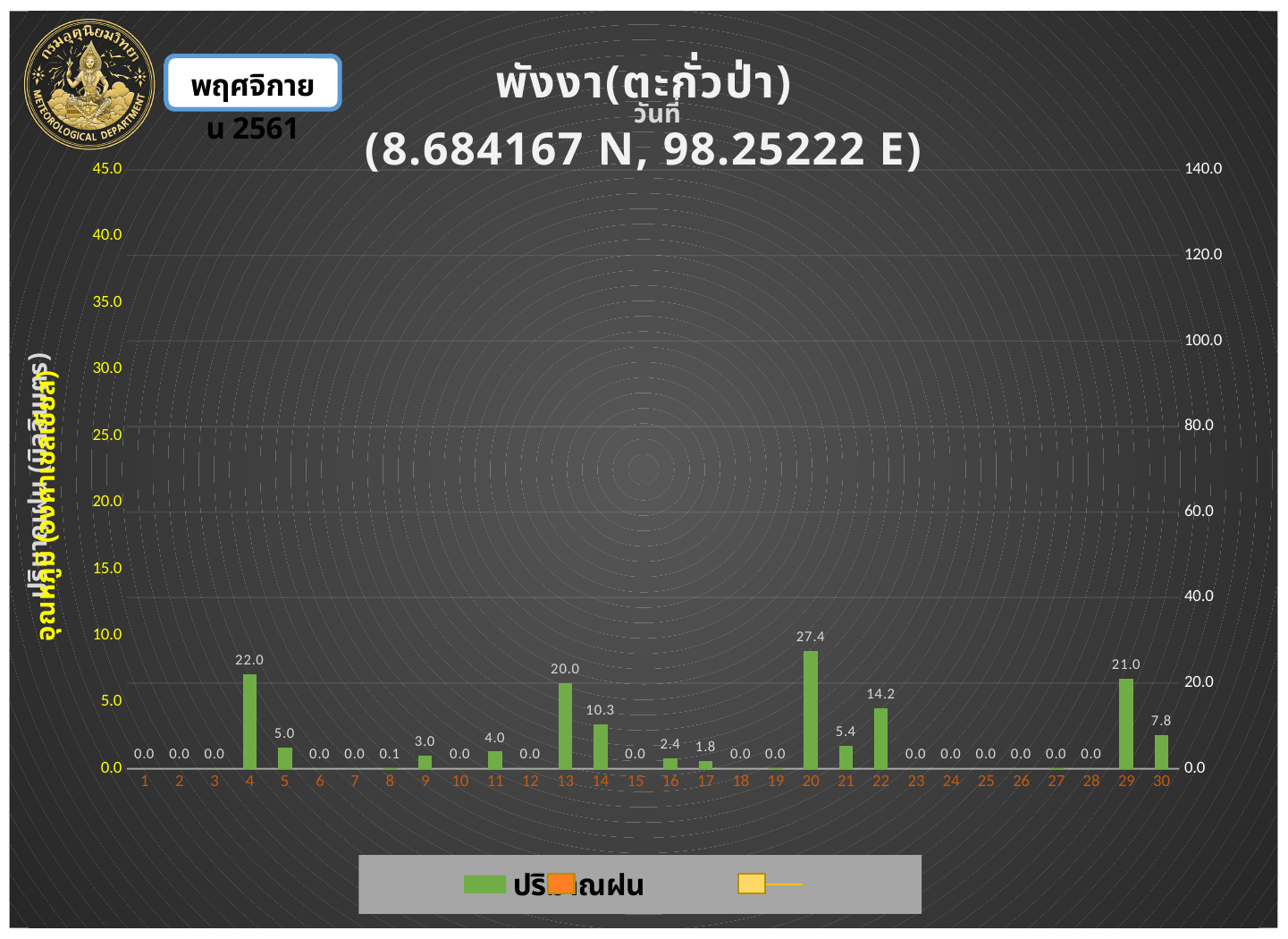
Which is larger, the rainfall value for day 5 or for day 21? day 21 What is the rainfall value for day 14? 10.3 Which day has the highest rainfall value? 20 What is the rainfall value for day 8? 0.1 What is the rainfall value for day 4? 22.0 What is the difference between the rainfall values for day 20 and day 29? 6.4 What coordinates are given in the chart title? 8.684167 N, 98.25222 E Which is larger, the rainfall value for day 22 or for day 30? day 22 What is the difference between the rainfall values for day 13 and day 14? 9.7 What is the rainfall value for day 20? 27.4 What kind of chart is shown on the slide? bar chart How many days are shown on the x axis? 30